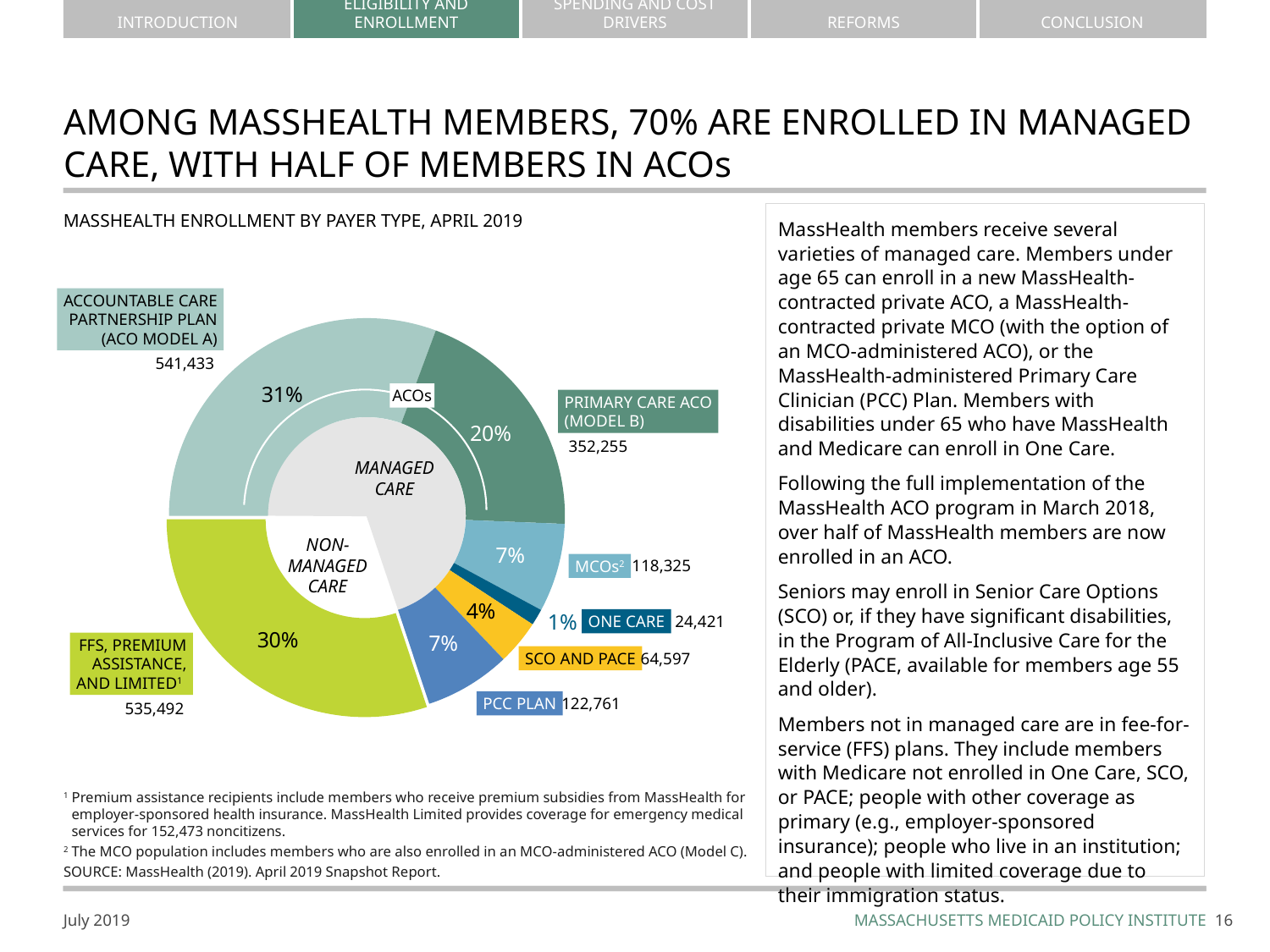
Which payer type has the largest share of MassHealth enrollment? Accountable Care Partnership Plan (ACO Model A) How many members are enrolled in MCOs? 118,325 What share of members are in One Care? 1% What is the title of the chart? MassHealth Enrollment by Payer Type, April 2019 What percentage of MassHealth members are in the Primary Care ACO (Model B)? 20% How many payer type segments are shown in the chart? 7 What is the difference in enrollment between the PCC Plan and MCOs? 4,436 How many members are enrolled in the Accountable Care Partnership Plan (ACO Model A)? 541,433 Which payer type has the smallest share of MassHealth enrollment? One Care What kind of chart is shown on the slide? Pie chart (donut) How many members are in SCO and PACE? 64,597 Which has more members: the Accountable Care Partnership Plan (ACO Model A) or FFS, Premium Assistance, and Limited? Accountable Care Partnership Plan (ACO Model A)